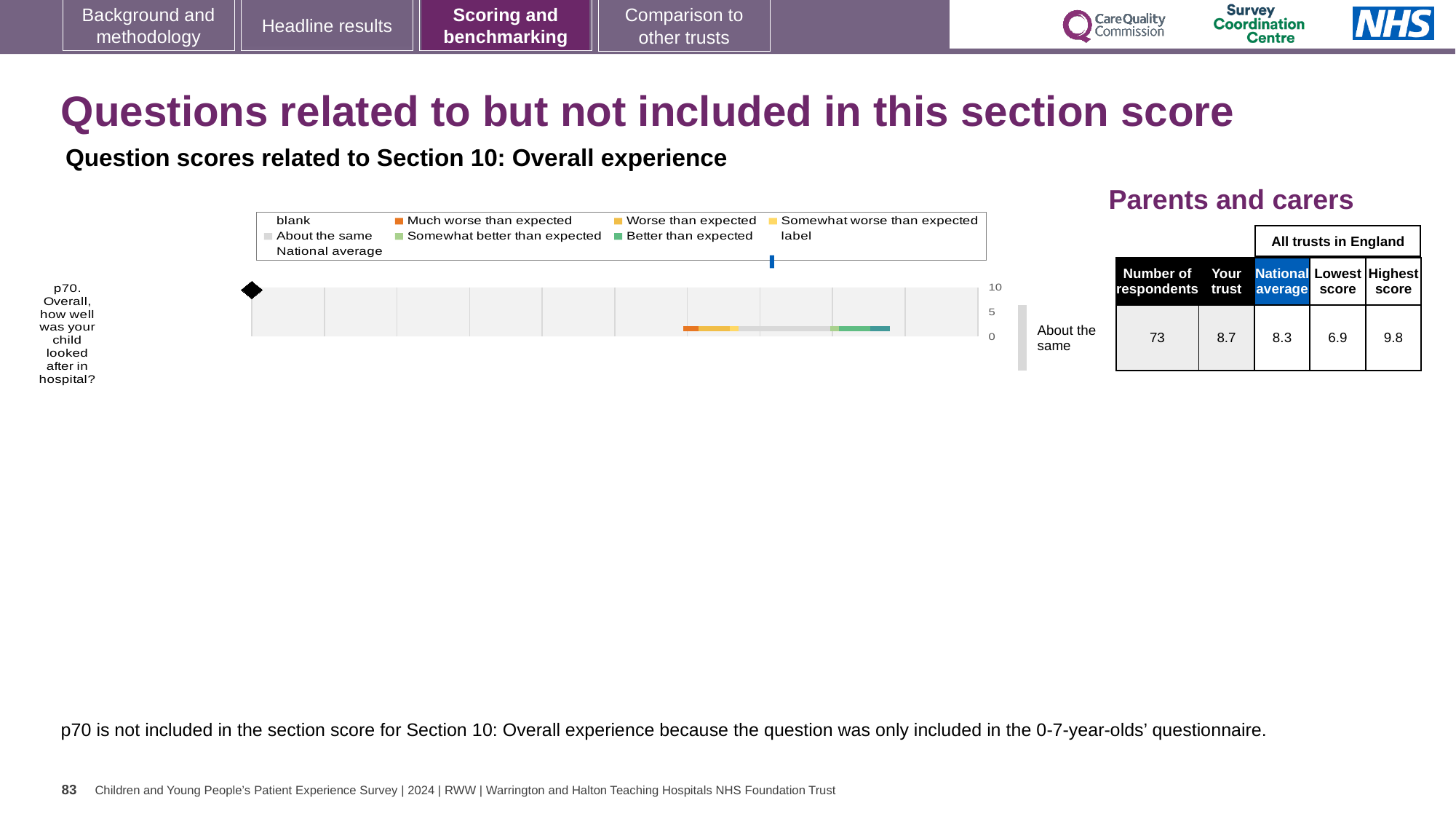
In the Parents and carers table, what is the 'Your trust' score for p70? 8.7 In the Parents and carers table, what is the lowest score among all trusts in England for p70? 6.9 How many respondents answered p70 according to the Parents and carers table? 73 How many survey questions are plotted in the chart? 1 In the Parents and carers table, what is the highest score among all trusts in England for p70? 9.8 What kind of chart is used to show the benchmarking result for p70? bar chart What benchmarking category label is shown to the right of the p70 bar? About the same For p70, how much higher is the 'Your trust' score than the national average? 0.4 For p70, what is the difference between the highest score and the lowest score among all trusts in England? 2.9 Which survey question is plotted in the chart? p70. Overall, how well was your child looked after in hospital? In the Parents and carers table, what is the national average score for p70? 8.3 For p70, which is higher: the 'Your trust' score or the national average? Your trust